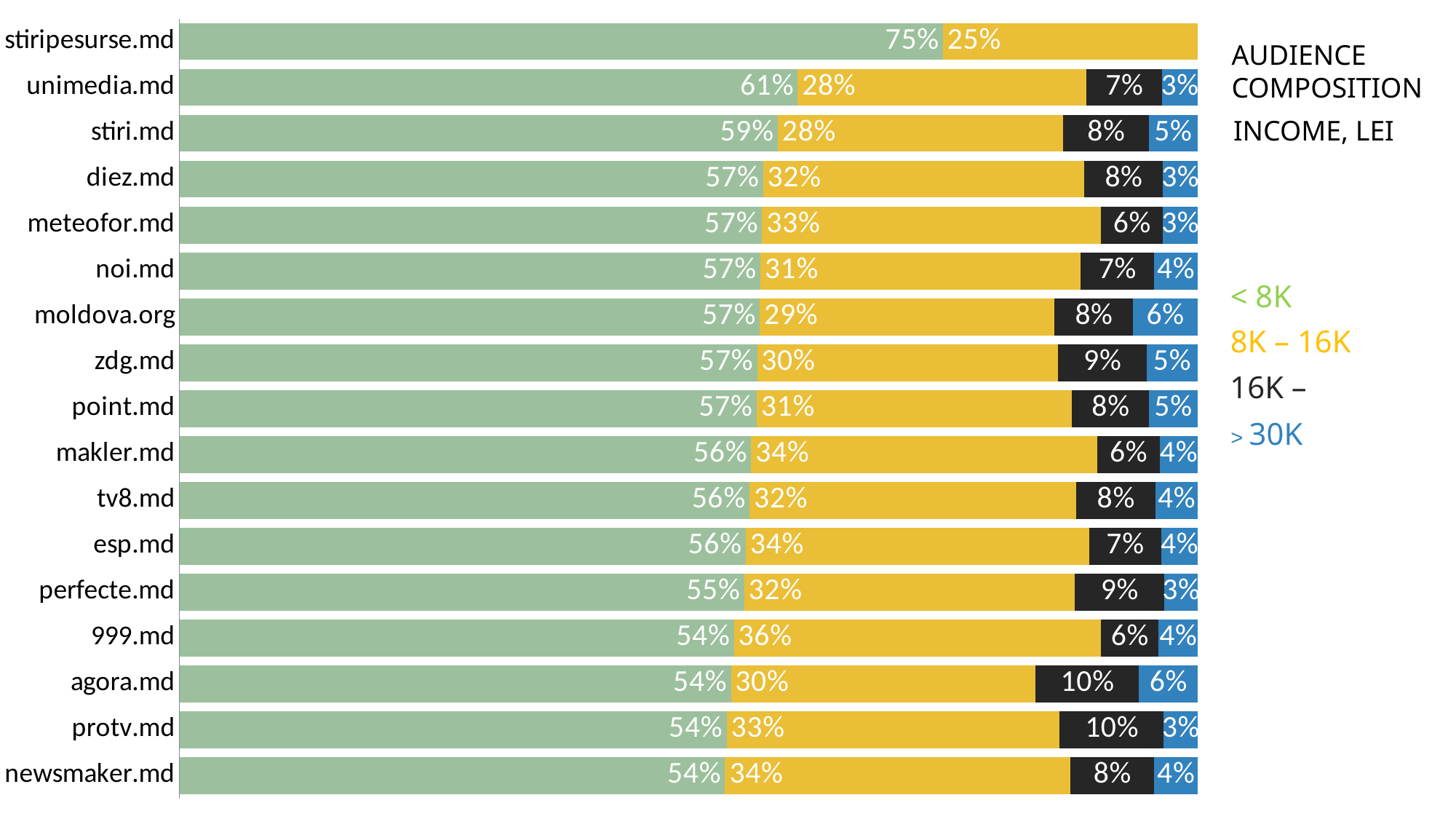
What is the title of the chart? AUDIENCE COMPOSITION INCOME, LEI What percentage of the 999.md audience falls in the 8K – 16K income band? 36% Which website has the lowest share of audience in the 8K – 16K income band? stiripesurse.md For unimedia.md, how many percentage points larger is the < 8K share than the 8K – 16K share? 33 percentage points Which website has the highest share of audience with income < 8K? stiripesurse.md What percentage of the stiripesurse.md audience has income < 8K? 75% How many income bands does the legend list? 4 What percentage of the agora.md audience falls in the 16K – income band? 10% What type of chart is shown on the slide? Stacked bar chart How many websites are shown in the chart? 17 Which has a larger 16K – share: zdg.md or tv8.md? zdg.md What percentage of the stiri.md audience has income > 30K? 5%